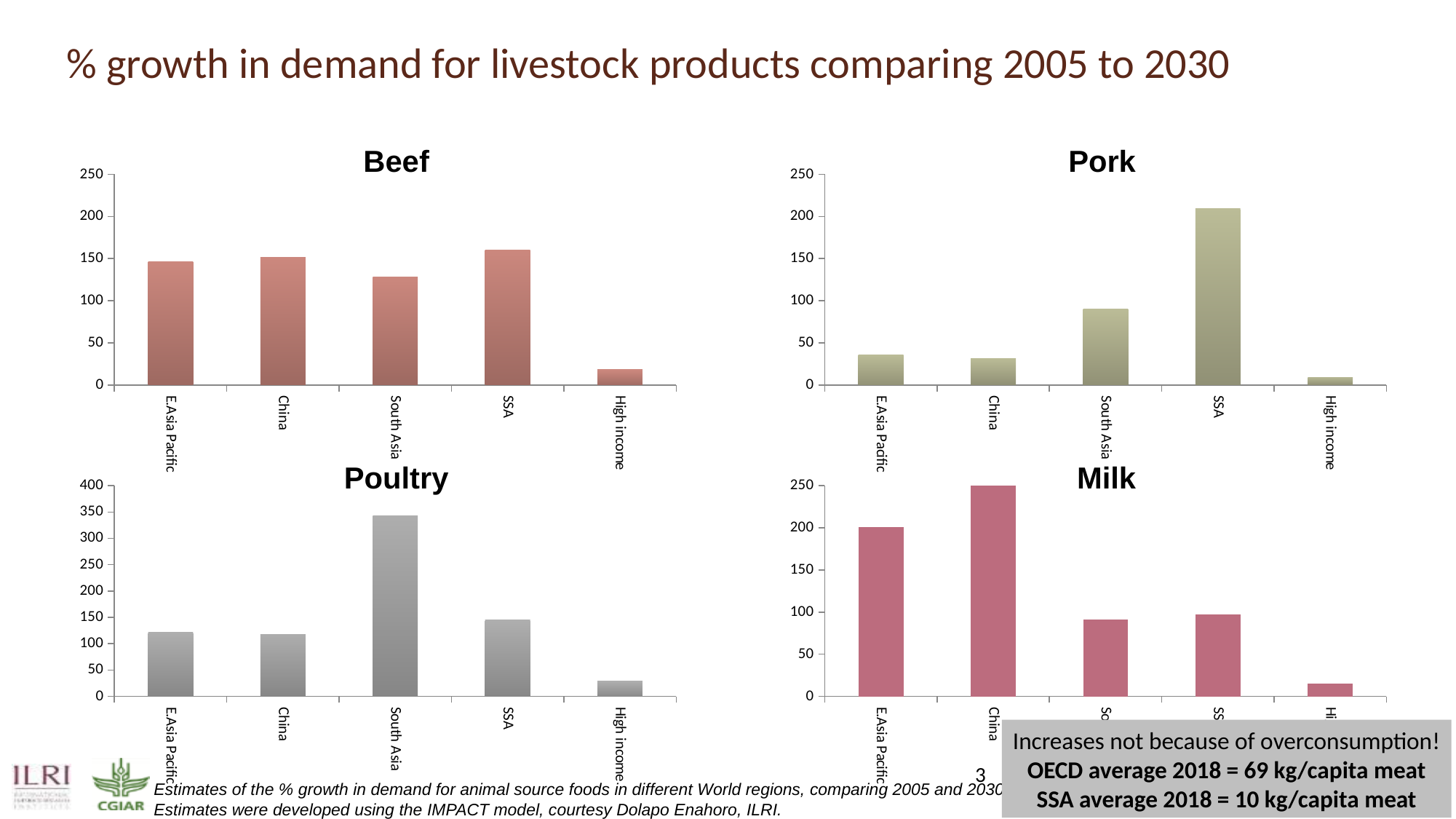
In the Beef chart, which region has the lowest % growth in demand? High income In the Milk chart, which region has the highest % growth in demand? China In the Pork chart, is the value for SSA greater or less than 200? greater In the Beef chart, is the value for High income greater or less than 50? less In the Poultry chart, is the value for South Asia greater or less than 300? greater In the Poultry chart, which is larger, the value for SSA or the value for High income? SSA In the Beef chart, which region has the highest % growth in demand? SSA How many regions are shown in the Pork chart? 5 In the Pork chart, which is larger, the value for South Asia or the value for China? South Asia What kind of chart is the Poultry chart? bar chart In the Poultry chart, which region has the highest % growth in demand? South Asia